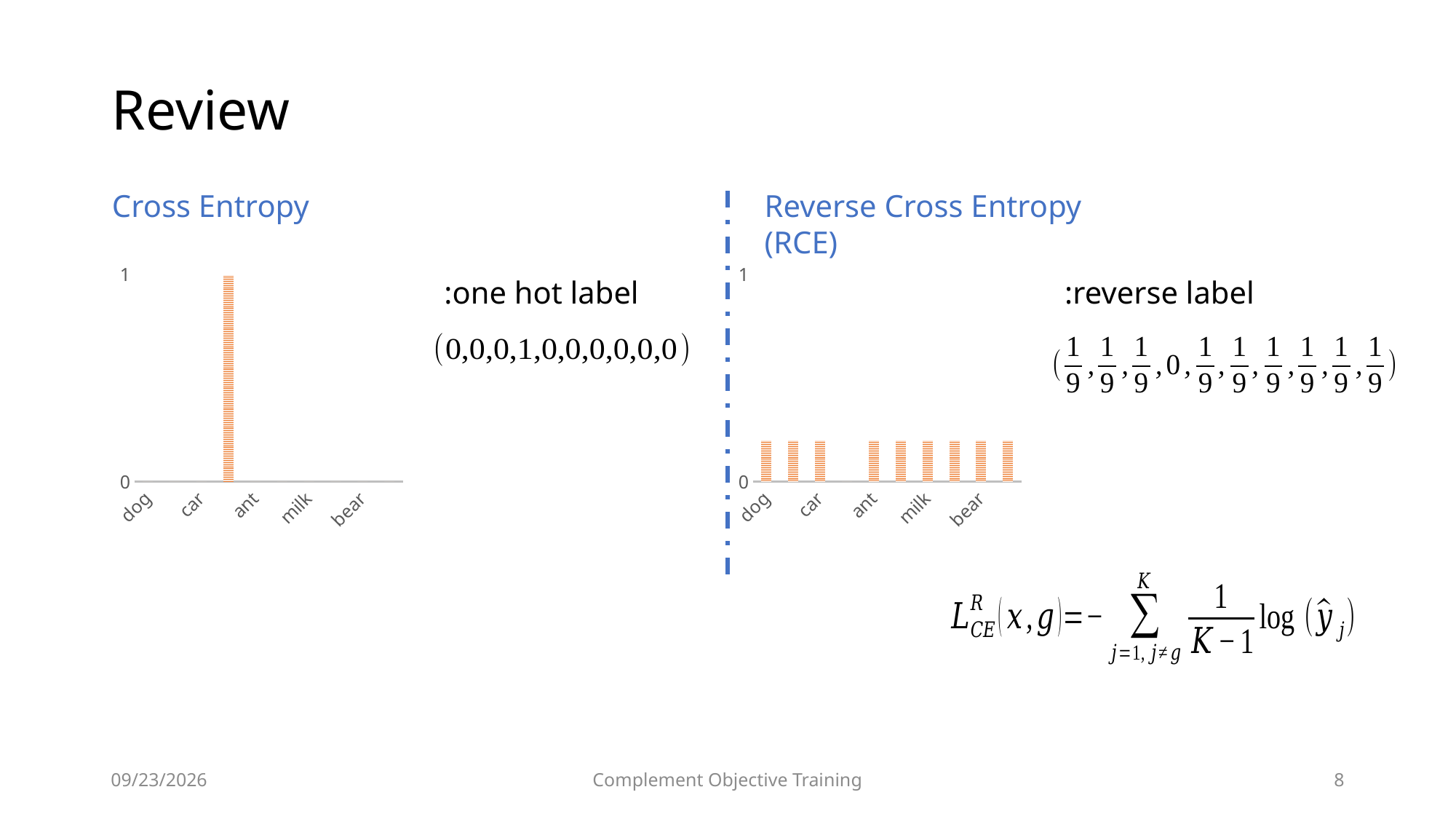
In the Reverse Cross Entropy (RCE) chart on the right, is the value for bear greater or less than 1? less In the Cross Entropy chart on the left, what is the value for milk? 0 What is the title above the chart on the right? Reverse Cross Entropy (RCE) In the Cross Entropy chart on the left, what is the value for dog? 0 How many bars are visible in the Reverse Cross Entropy (RCE) chart on the right? 9 How many category labels are shown on the x axis of the Cross Entropy chart on the left? 5 How many bars are visible in the Cross Entropy chart on the left? 1 In the Cross Entropy chart on the left, what is the value for bear? 0 What kind of chart is the Reverse Cross Entropy (RCE) chart on the right? bar chart What colour are the bars in the Cross Entropy chart on the left? orange What kind of chart is the Cross Entropy chart on the left? bar chart In the Reverse Cross Entropy (RCE) chart on the right, is the value for dog greater or less than 1? less